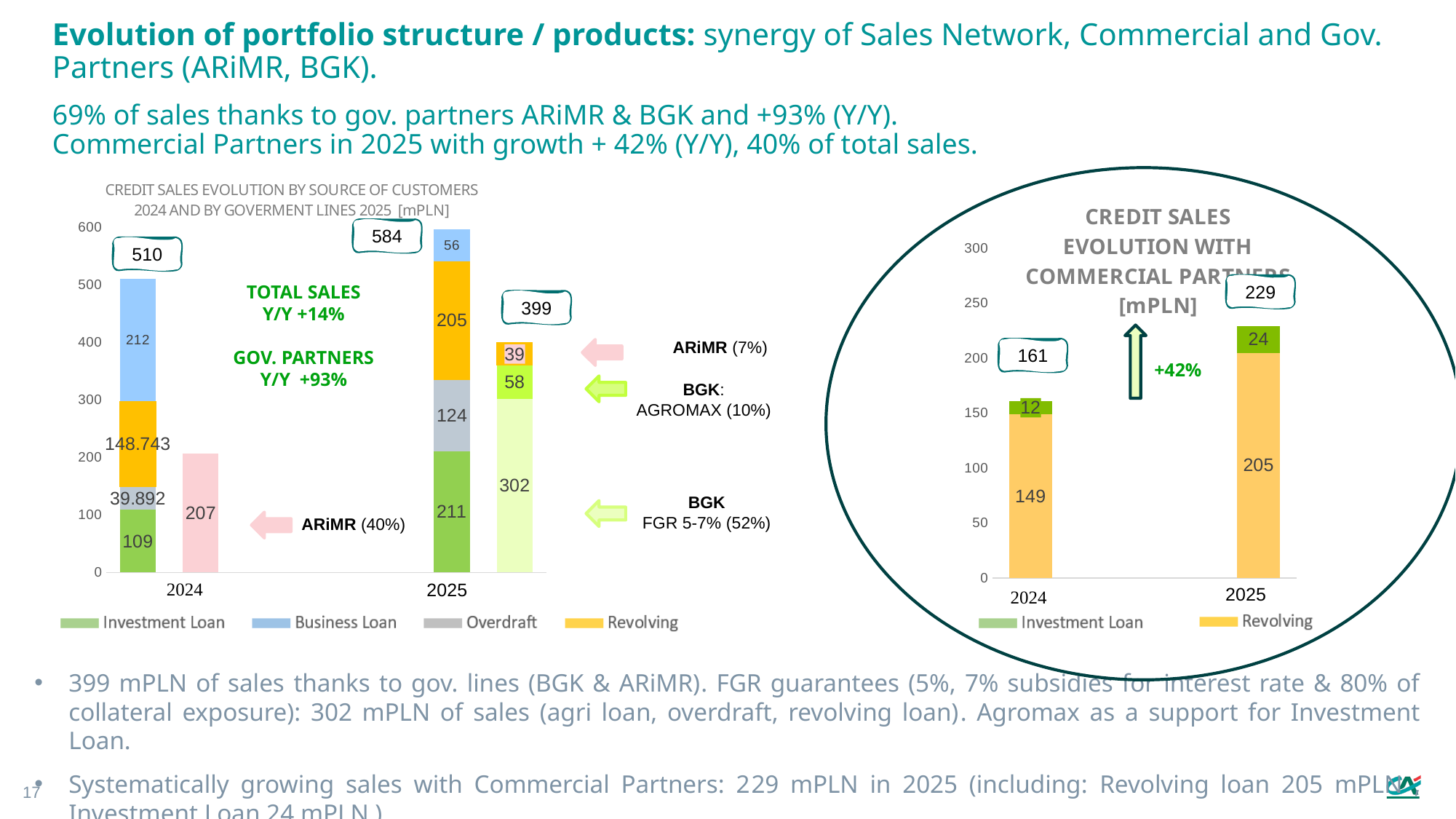
In the chart on the left (Credit Sales Evolution by Source of Customers), what is the Business Loan value for 2024? 212 In the chart on the right (Credit Sales Evolution with Commercial Partners), what is the total of the 2025 stacked bar? 229 In the chart on the left (Credit Sales Evolution by Source of Customers), what is the Investment Loan value for 2025? 211 In the chart on the right (Credit Sales Evolution with Commercial Partners), what is the difference between the Revolving values for 2025 and 2024? 56 In the chart on the left (Credit Sales Evolution by Source of Customers), which is larger: the Business Loan value for 2024 or for 2025? 2024 In the chart on the right (Credit Sales Evolution with Commercial Partners), what is the Revolving value for 2025? 205 In the chart on the right (Credit Sales Evolution with Commercial Partners), what is the Investment Loan value for 2024? 12 In the chart on the left (Credit Sales Evolution by Source of Customers), how many series does the legend list? 4 In the chart on the left (Credit Sales Evolution by Source of Customers), what is the Overdraft value for 2024? 39.892 In the chart on the right (Credit Sales Evolution with Commercial Partners), how many series does the legend list? 2 What kind of chart is the chart on the right (Credit Sales Evolution with Commercial Partners)? Stacked bar chart